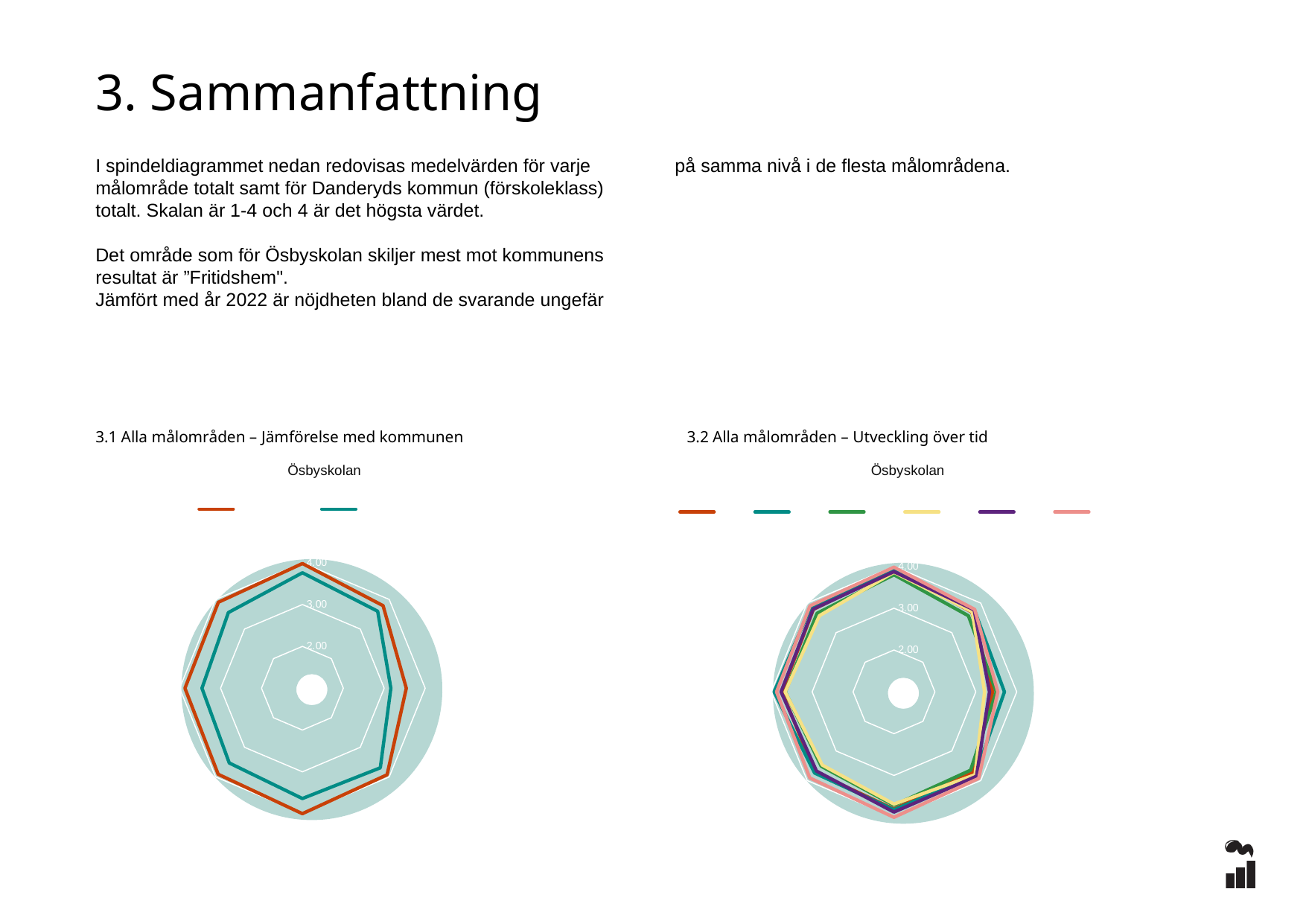
How many series does the legend of the left chart (3.1 Alla målområden – Jämförelse med kommunen) list? 2 What kind of chart is the chart titled "3.1 Alla målområden – Jämförelse med kommunen"? Radar (spider) chart What kind of chart is the chart titled "3.2 Alla målområden – Utveckling över tid"? Radar (spider) chart How many axes (categories) does the right chart (3.2 Alla målområden – Utveckling över tid) have? 8 In the right chart (3.2 Alla målområden – Utveckling över tid), are the plotted values greater or less than 2.00 on all axes? greater In the left chart (3.1 Alla målområden – Jämförelse med kommunen), are the values of the teal series greater or less than 3.00 on all axes? greater In the left chart (3.1 Alla målområden – Jämförelse med kommunen), which series has the larger values on every axis, the orange one or the teal one? The orange one What title is shown above the plot area of the right chart (3.2 Alla målområden – Utveckling över tid)? Ösbyskolan How many series does the legend of the right chart (3.2 Alla målområden – Utveckling över tid) list? 6 How many axes (categories) does the left chart (3.1 Alla målområden – Jämförelse med kommunen) have? 8 What is the highest value labelled on the scale of the left chart (3.1 Alla målområden – Jämförelse med kommunen)? 4.00